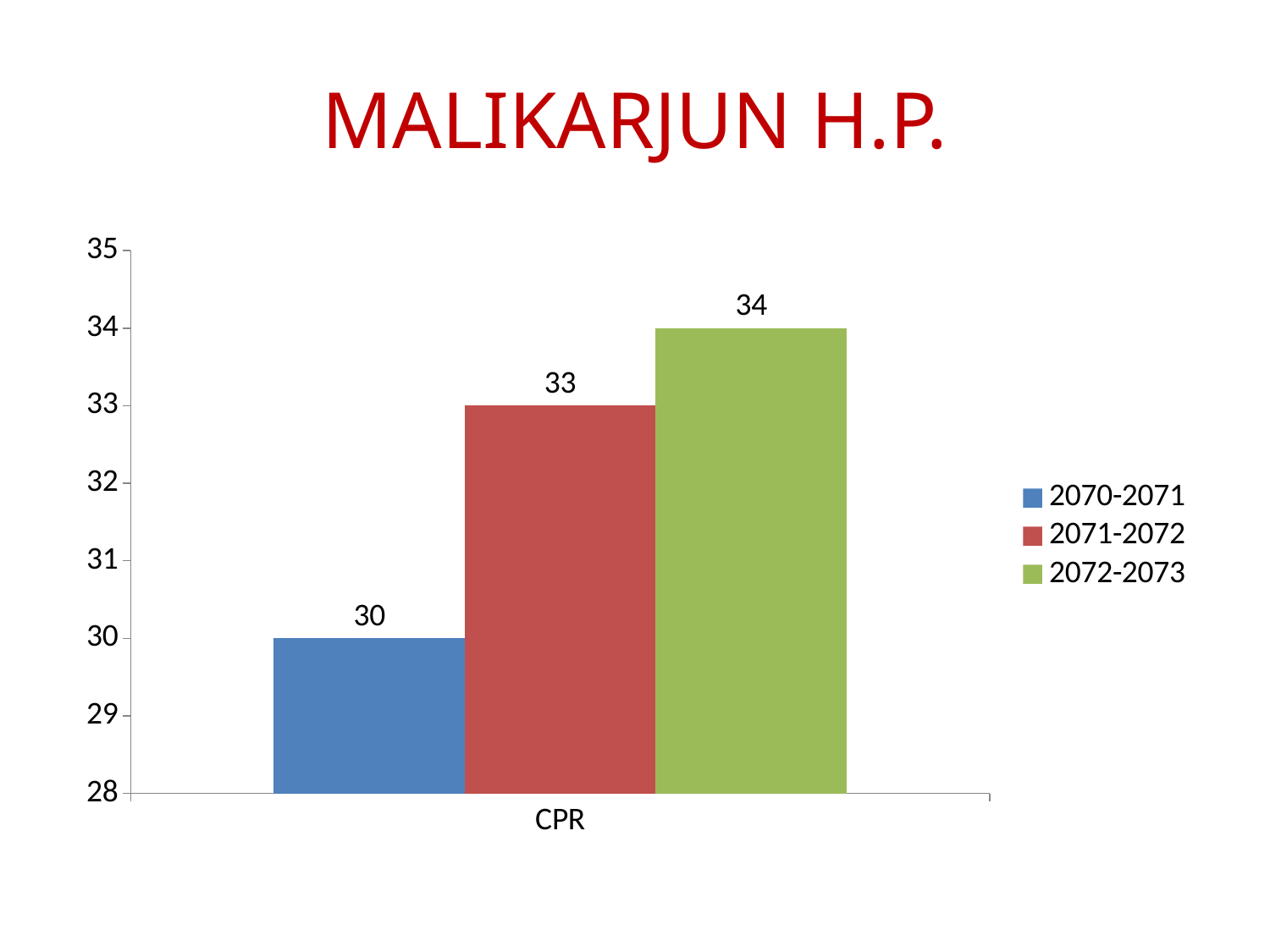
Do the CPR values rise or fall from 2070-2071 to 2072-2073? Rise Which series has the lowest CPR value? 2070-2071 What is the difference between the CPR values for 2072-2073 and 2070-2071? 4 Which series has the highest CPR value? 2072-2073 Which is larger, the CPR value for 2071-2072 or for 2072-2073? 2072-2073 What is the title of the slide containing the chart? MALIKARJUN H.P. How many series does the legend list? 3 What is the difference between the CPR values for 2071-2072 and 2070-2071? 3 What is the CPR value for 2070-2071? 30 What is the CPR value for 2072-2073? 34 What is the CPR value for 2071-2072? 33 What kind of chart is shown on the slide? Bar chart